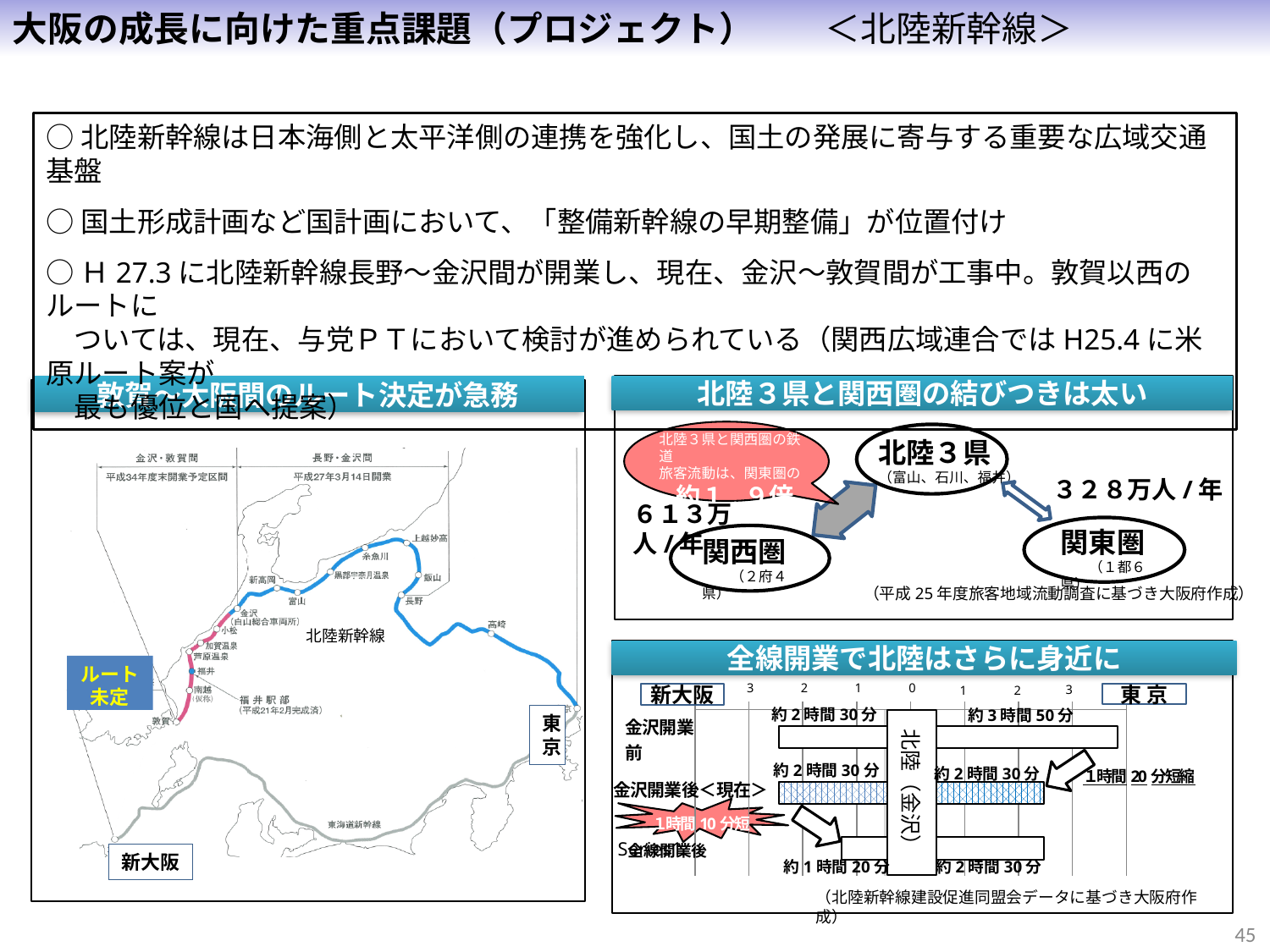
In the bottom-right chart titled 全線開業で北陸はさらに身近に, what is the travel time between 新大阪 and 北陸(金沢) for 金沢開業後<現在>? 約2時間30分 In the top-right diagram titled 北陸３県と関西圏の結びつきは太い, how many passengers per year travel between 北陸３県 and 関東圏? ３２８万人/年 In the bottom-right chart titled 全線開業で北陸はさらに身近に, does the 新大阪–金沢 travel time rise or fall going from 金沢開業前 to 全線開業後? fall In the bottom-right chart titled 全線開業で北陸はさらに身近に, which scenario has the longest 金沢–東京 travel time? 金沢開業前 In the top-right diagram titled 北陸３県と関西圏の結びつきは太い, which has more passenger flow with 北陸３県: 関西圏 or 関東圏? 関西圏 In the bottom-right chart titled 全線開業で北陸はさらに身近に, how many scenarios (rows) are shown? 3 In the bottom-right chart titled 全線開業で北陸はさらに身近に, how much shorter is the 金沢–東京 travel time after 金沢開業 compared with before, as labelled on the chart? 1時間20分短縮 What kind of chart is the bottom-right chart titled 全線開業で北陸はさらに身近に? bar chart In the bottom-right chart titled 全線開業で北陸はさらに身近に, what is the travel time between 北陸(金沢) and 東京 for 金沢開業前? 約3時間50分 In the top-right diagram titled 北陸３県と関西圏の結びつきは太い, how many passengers per year travel between 北陸３県 and 関西圏? ６１３万人/年 In the bottom-right chart titled 全線開業で北陸はさらに身近に, what is the travel time between 新大阪 and 北陸(金沢) after 全線開業後? 約1時間20分 In the bottom-right chart titled 全線開業で北陸はさらに身近に, how much shorter is the 新大阪–金沢 travel time after 全線開業 compared with the current time, as labelled on the chart? 1時間10分短縮